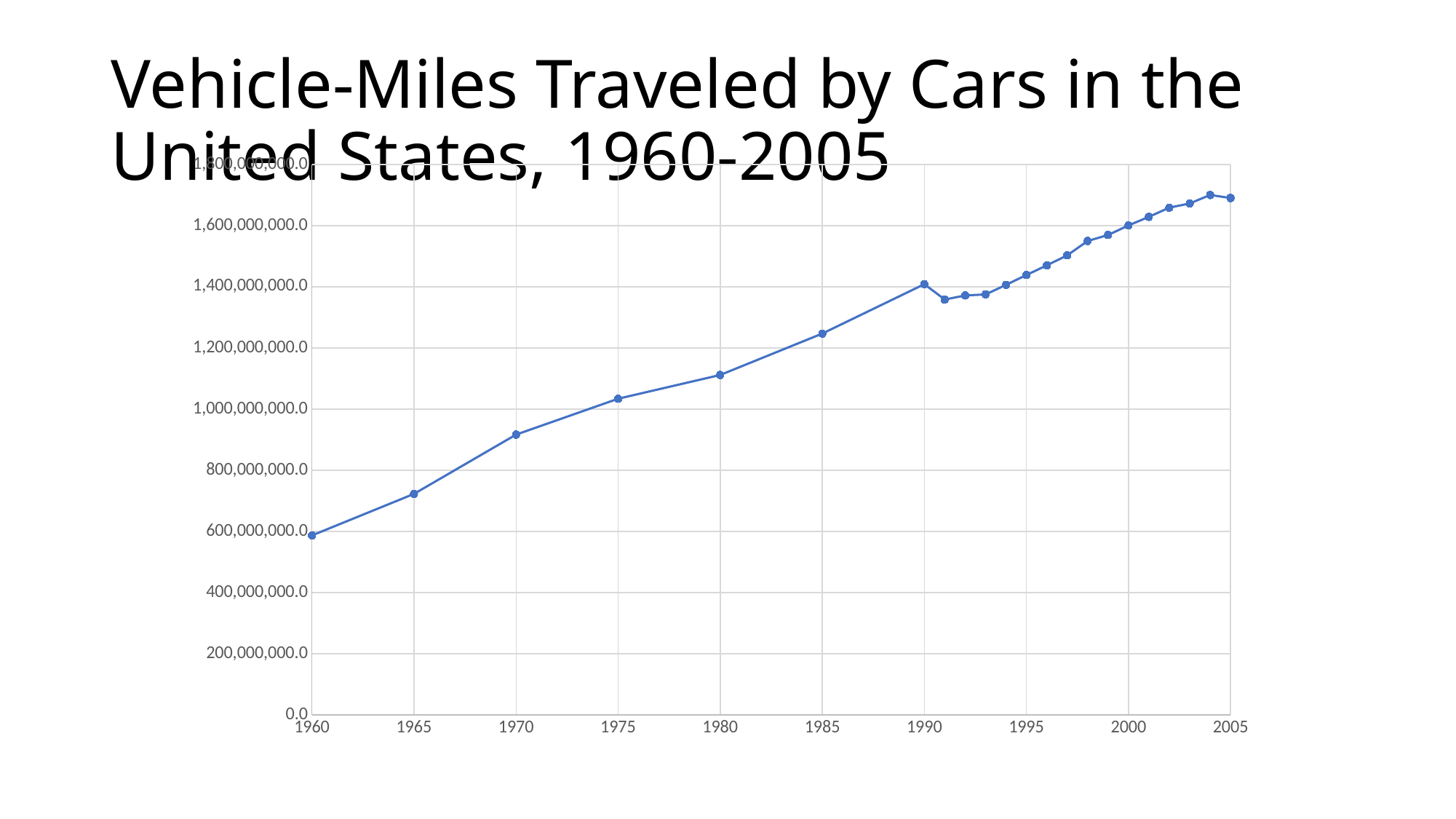
Is the value for 1980 greater or less than 1,000,000,000.0? greater Is the value for 1970 greater or less than 800,000,000.0? greater Is the value for 2005 greater or less than 1,600,000,000.0? greater Which year has the lowest value on the chart? 1960 How many data points are plotted on the line? 22 What kind of chart is shown on the slide? line chart Which is larger, the value for 1990 or the value for 1991? 1990 What is the title of the chart? Vehicle-Miles Traveled by Cars in the United States, 1960-2005 Do the values generally rise or fall from 1960 to 2005? rise